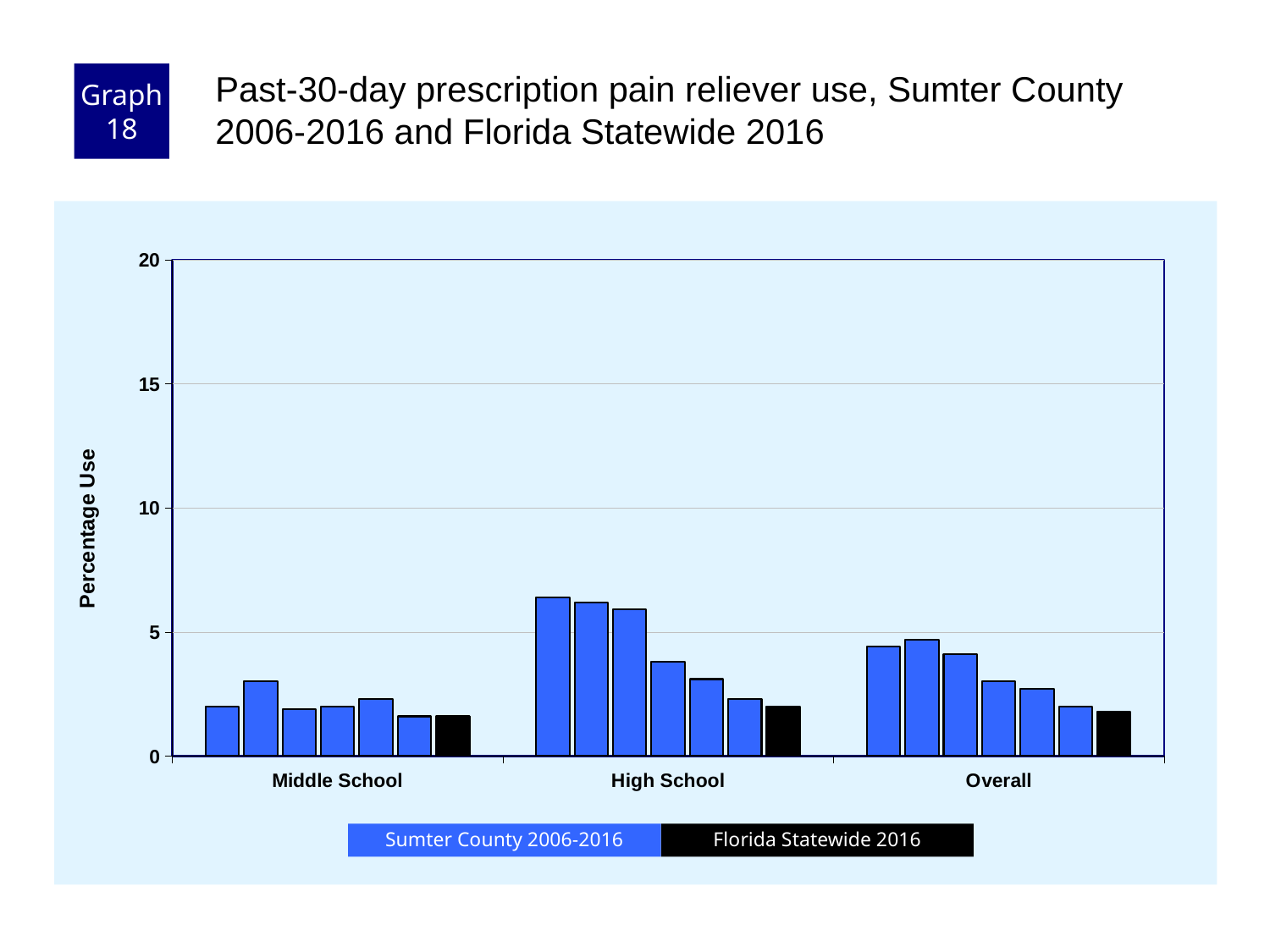
Is the Florida Statewide 2016 value for Overall greater or less than 5? less How many categories are shown on the x axis? 3 Which category has the lowest bars overall? Middle School Is the value of the tallest Sumter County 2006-2016 bar for High School greater or less than 5? greater Do the Sumter County 2006-2016 bars for High School rise or fall from left to right? fall Which category has the tallest bar overall? High School What is the label on the y axis? Percentage Use Which colour represents Florida Statewide 2016 in the legend? black What kind of chart is shown on the slide? bar chart How many series does the legend list? 2 Is the tallest Sumter County 2006-2016 bar for Middle School greater or less than 5? less Which is larger: the tallest Sumter County bar for High School or the tallest Sumter County bar for Overall? High School